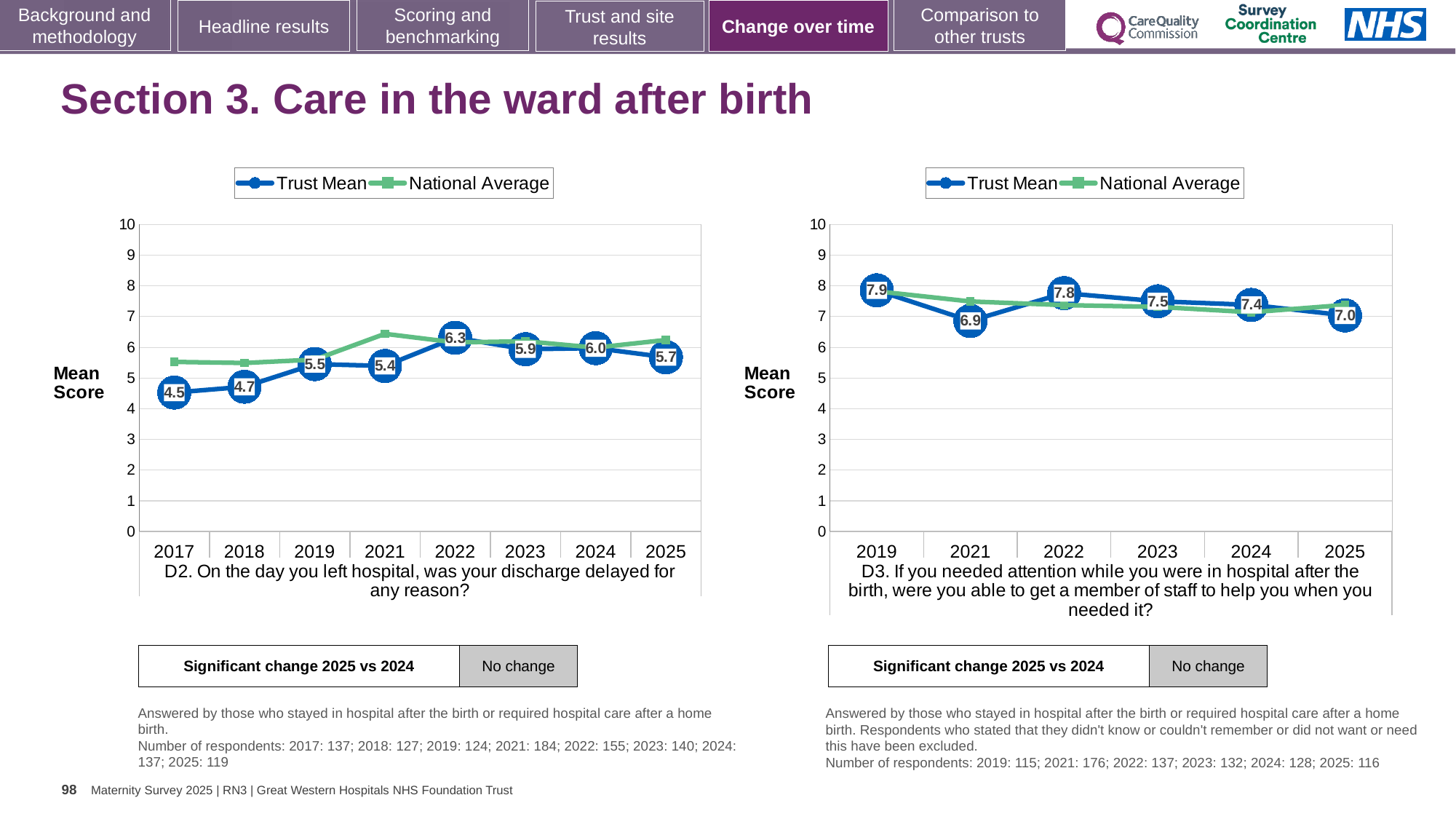
In the D2 chart (left), what is the difference between the Trust Mean for 2022 and 2017? 1.8 In the D2 chart (left), how many years are shown on the x axis? 8 In the D3 chart (right), what is the Trust Mean for 2021? 6.9 In the D2 chart (left), what is the Trust Mean for 2017? 4.5 In the D3 chart (right), what is the Trust Mean for 2025? 7.0 In the D3 chart (right), is the Trust Mean for 2019 larger or smaller than the Trust Mean for 2021? larger What kind of chart is the D2 chart on the left? line chart In the D3 chart (right), how many series does the legend list? 2 In the D2 chart (left), what is the Trust Mean for 2022? 6.3 In the D2 chart (left), which year has the highest Trust Mean? 2022 In the D2 chart (left), which year has the lowest Trust Mean? 2017 In the D3 chart (right), which year has the highest Trust Mean? 2019